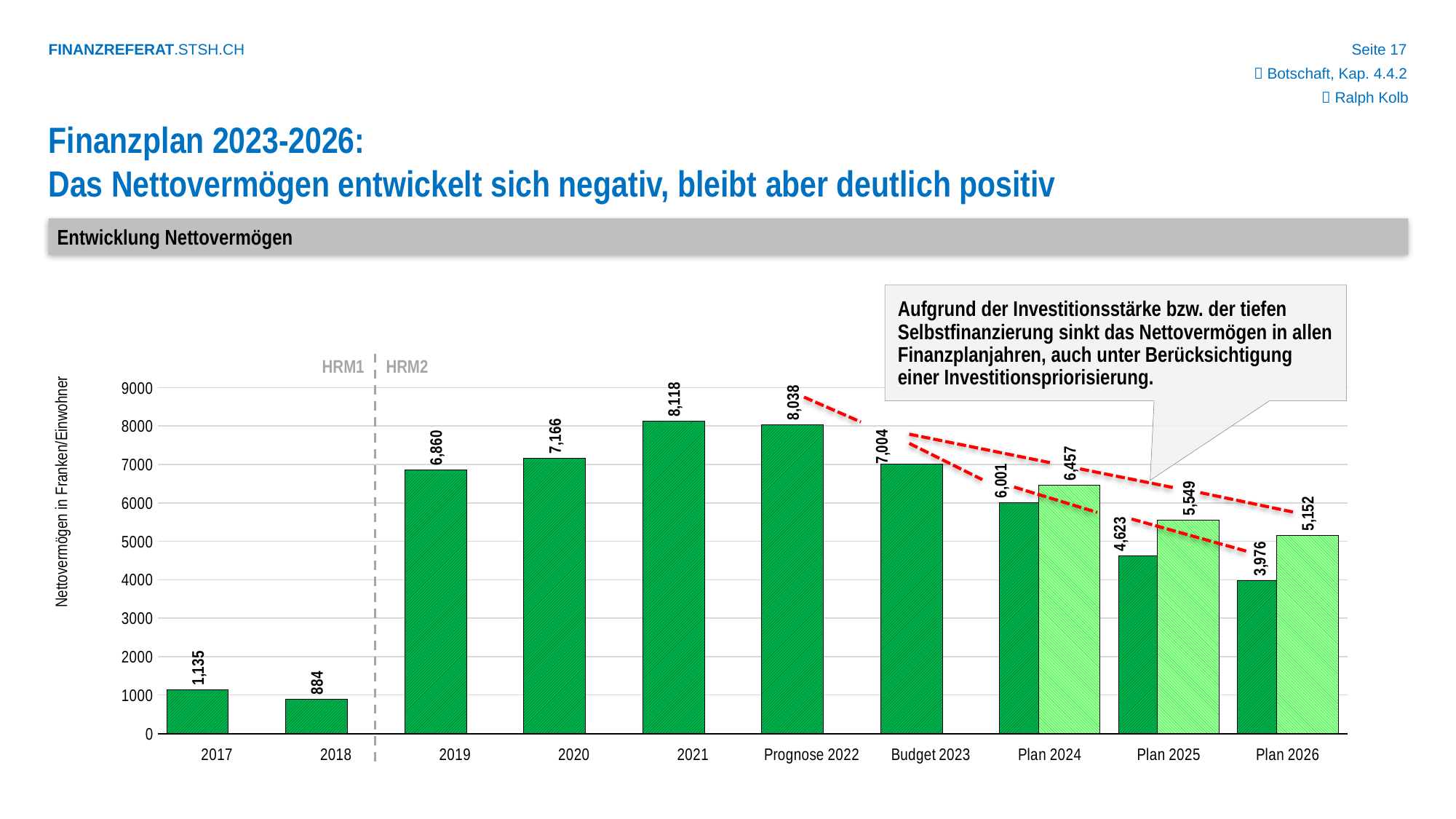
What is the value of the light green bar for Plan 2025? 5,549 What is the value of the dark green bar for Plan 2026? 3,976 What is the difference between the value for 2020 and the value for 2019? 306 Which is larger, the value for Budget 2023 or the value for 2019? Budget 2023 How many categories are shown on the x axis? 10 Which year has the lowest value in the chart? 2018 Which year has the highest value in the chart? 2021 For Plan 2024, what is the difference between the light green bar and the dark green bar? 456 What kind of chart is shown on the slide? Bar chart What is the label of the vertical axis? Nettovermögen in Franken/Einwohner What is the value for Prognose 2022? 8,038 What is the value for 2021 in the Entwicklung Nettovermögen chart? 8,118